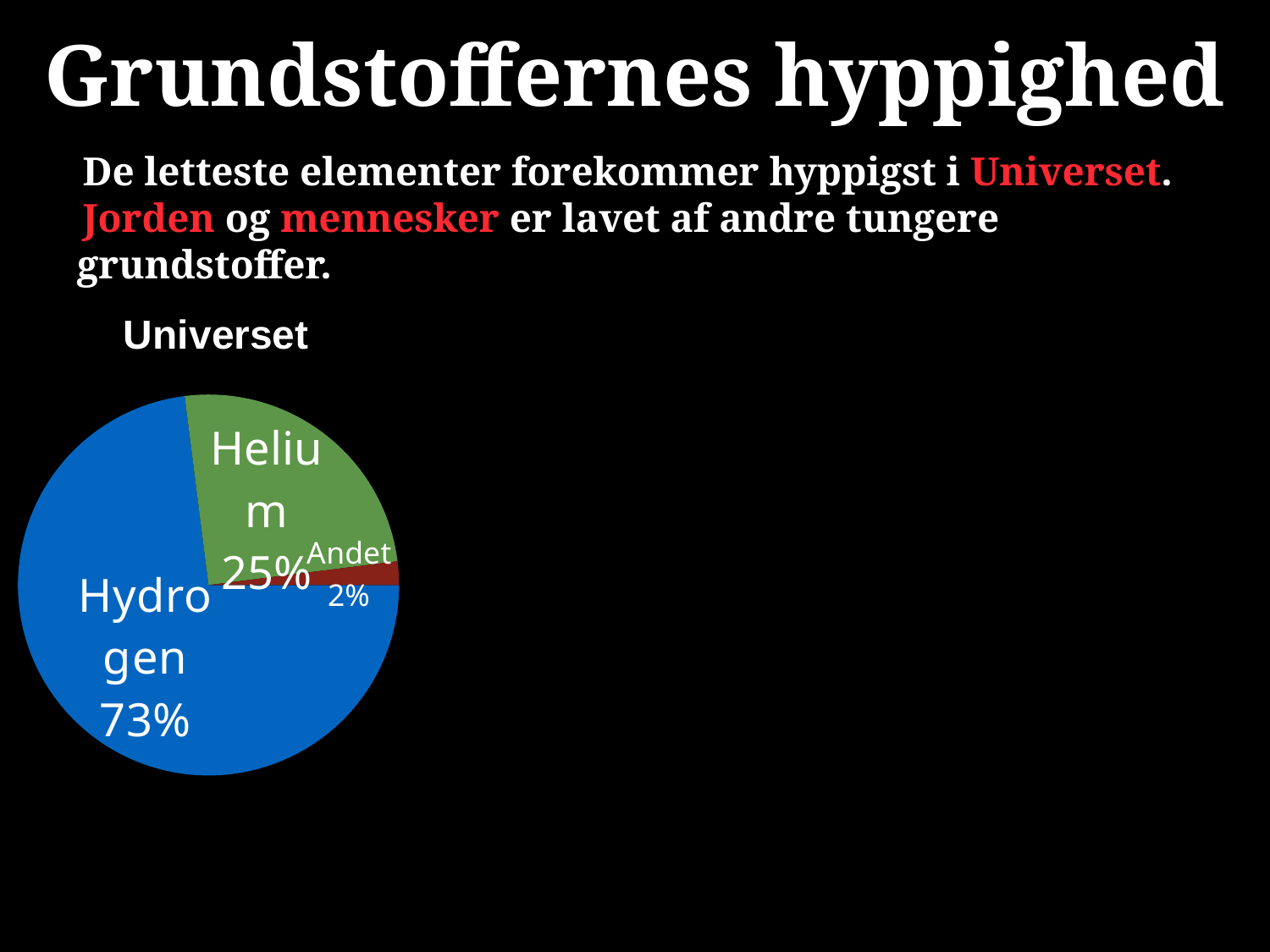
What share of the pie does Hydrogen have? 73% Which is larger, the Helium slice or the Andet slice? Helium What colour is the Hydrogen slice? blue Which slice of the pie chart is the smallest? Andet What is the difference in percentage points between Hydrogen and Helium? 48 What share of the pie does Helium have? 25% What kind of chart is shown on the slide? pie chart What is the difference in percentage points between Helium and Andet? 23 Which slice of the pie chart is the largest? Hydrogen How many slices does the pie chart have? 3 What is the title of the pie chart? Universet What share of the pie does Andet have? 2%